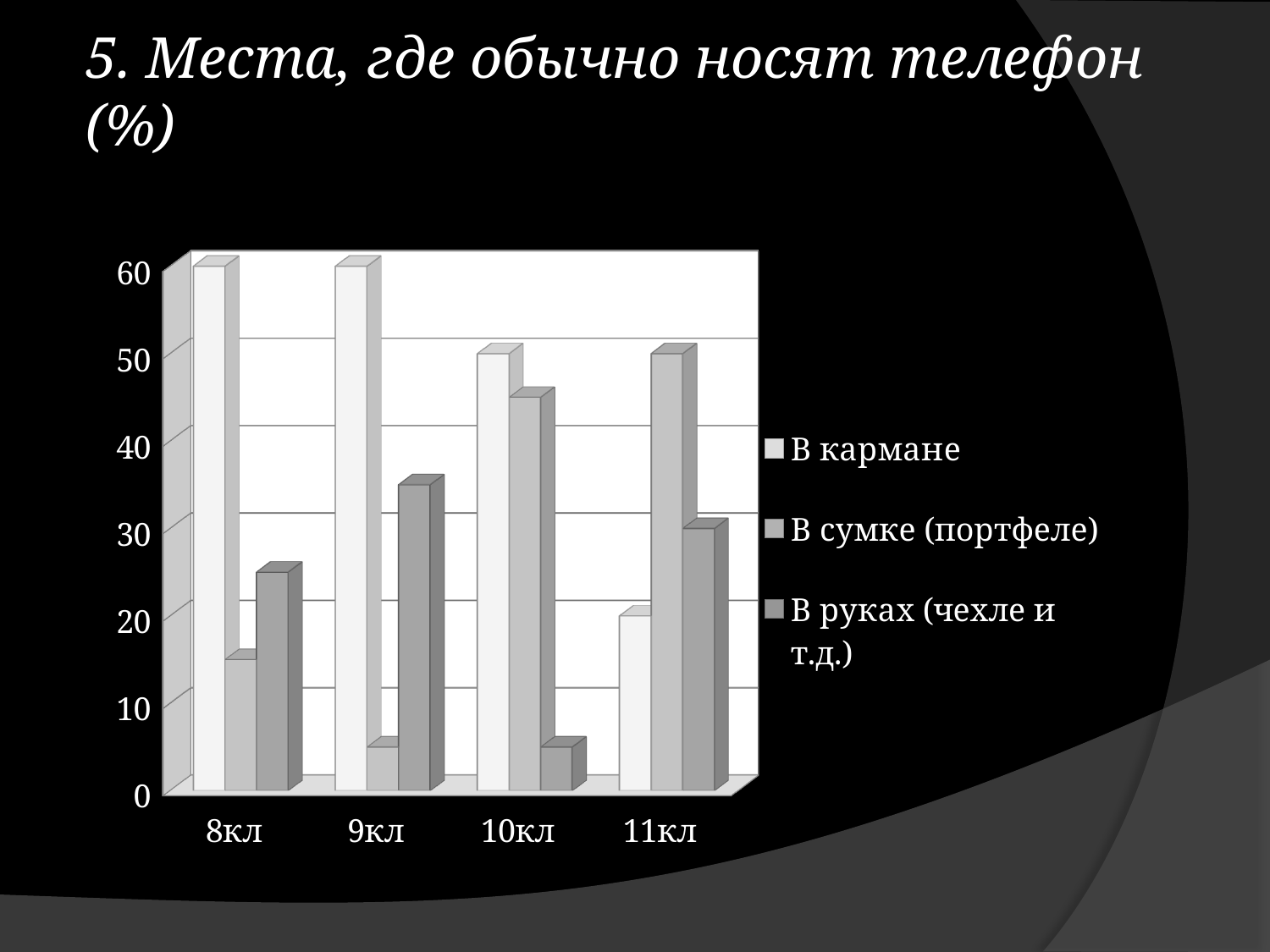
Is the value for В руках (чехле и т.д.) in 9кл greater or less than 30? greater How many class categories are shown on the x axis? 4 In 8кл, which is larger: В сумке (портфеле) or В руках (чехле и т.д.)? В руках (чехле и т.д.) Which class has the lowest value for В кармане? 11кл Which series has the highest value in 11кл? В сумке (портфеле) How many series does the legend list? 3 Is the value for В сумке (портфеле) in 8кл greater or less than 20? less Which series is listed last in the legend? В руках (чехле и т.д.) Is the value for В сумке (портфеле) in 10кл greater or less than 40? greater What kind of chart is shown on the slide? bar chart What is the title of the chart? 5. Места, где обычно носят телефон (%)